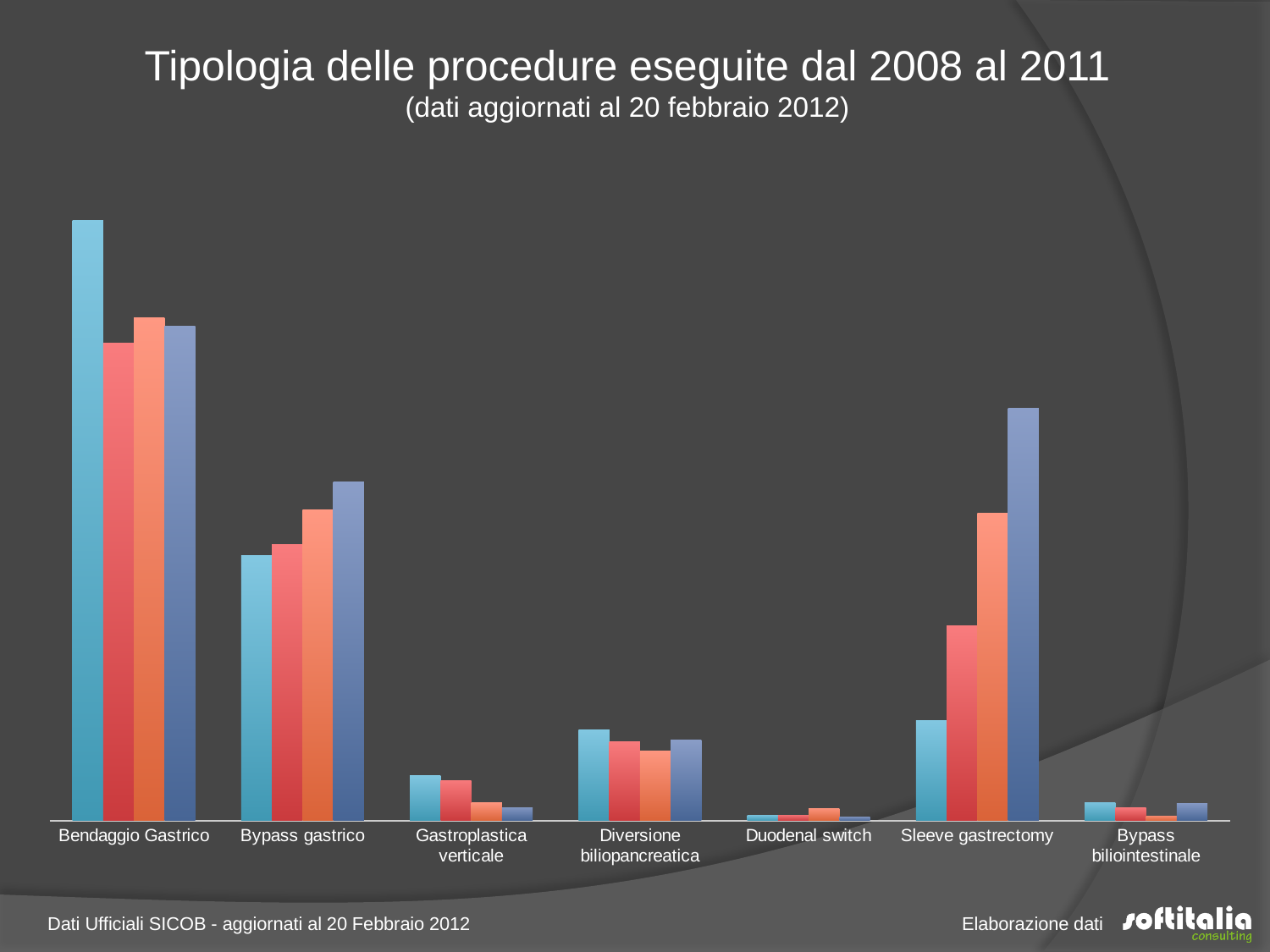
Which is taller: the first (light blue) bar for Bendaggio Gastrico or the first (light blue) bar for Bypass gastrico? Bendaggio Gastrico According to the subtitle, to what date are the chart's data updated? 20 febbraio 2012 What is the title of the chart on the slide? Tipologia delle procedure eseguite dal 2008 al 2011 Which is taller: the last (blue) bar for Sleeve gastrectomy or the last (blue) bar for Bypass gastrico? Sleeve gastrectomy Within the Sleeve gastrectomy category, do the bars rise or fall from left to right? rise Which procedure category has the tallest bar in the chart? Bendaggio Gastrico How many procedure categories are shown on the x axis of the chart? 7 How many bars are plotted for each procedure category? 4 What kind of chart is shown on the slide? bar chart Which is taller: the first (light blue) bar for Diversione biliopancreatica or the first (light blue) bar for Gastroplastica verticale? Diversione biliopancreatica Within the Gastroplastica verticale category, do the bars rise or fall from left to right? fall Which procedure category has the lowest bars overall in the chart? Duodenal switch